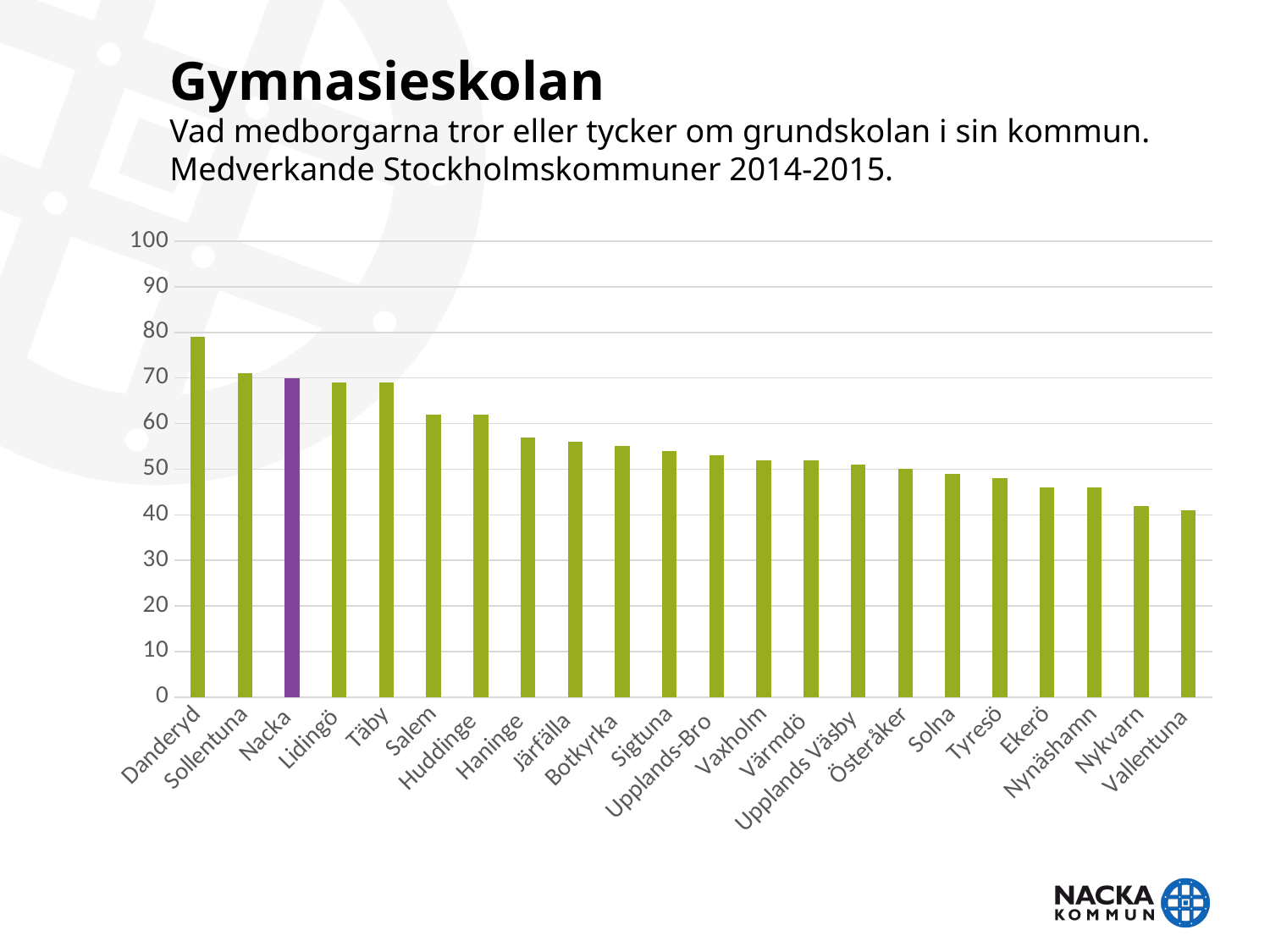
Which municipality's bar is shown in a different colour (purple) from the others? Nacka How many municipalities are shown on the x axis of the chart? 22 Is the value for Haninge greater or less than 60? less Is the value for Danderyd greater or less than 70? greater Which has the larger value, Huddinge or Haninge? Huddinge Which has the larger value, Danderyd or Sollentuna? Danderyd Is the value for Vallentuna greater or less than 50? less Which municipality has the highest value in the chart? Danderyd What kind of chart is shown on the slide? bar chart Do the values rise or fall moving from left to right along the x axis? fall